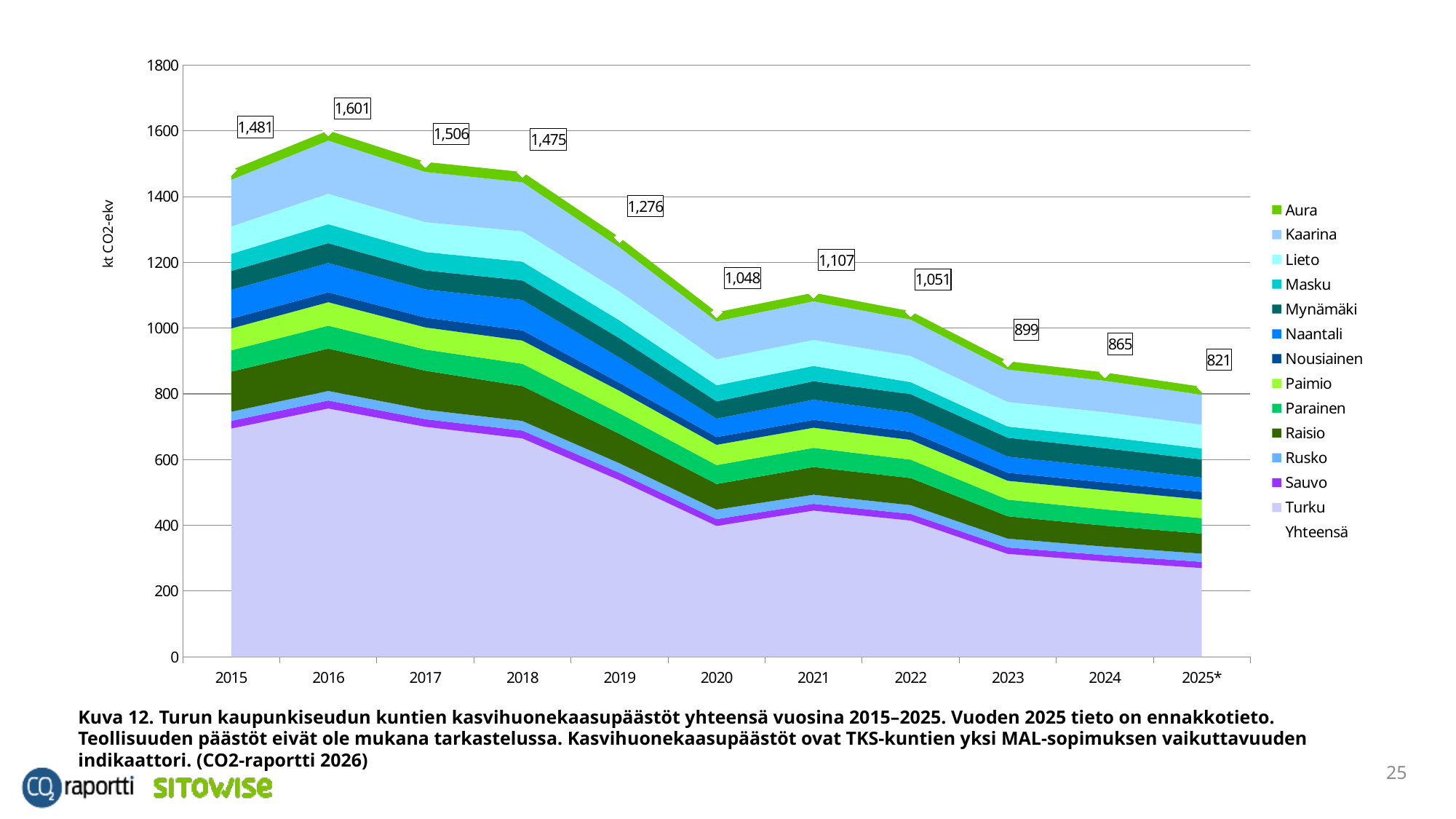
What is the difference between the labelled totals for 2016 and 2015? 120 Is the value for Turku in 2015 greater or less than 600? greater Which year has the highest labelled total? 2016 What is the total emissions value labelled for 2016? 1,601 What kind of chart is shown on the slide? Stacked area chart How many years are shown on the x axis? 11 What is the total emissions value labelled for 2025*? 821 Which year has the lowest labelled total? 2025* Which year has a larger labelled total, 2021 or 2022? 2021 What is the difference between the labelled totals for 2015 and 2025*? 660 How many entries does the legend list? 14 What is the total emissions value labelled for 2020? 1,048